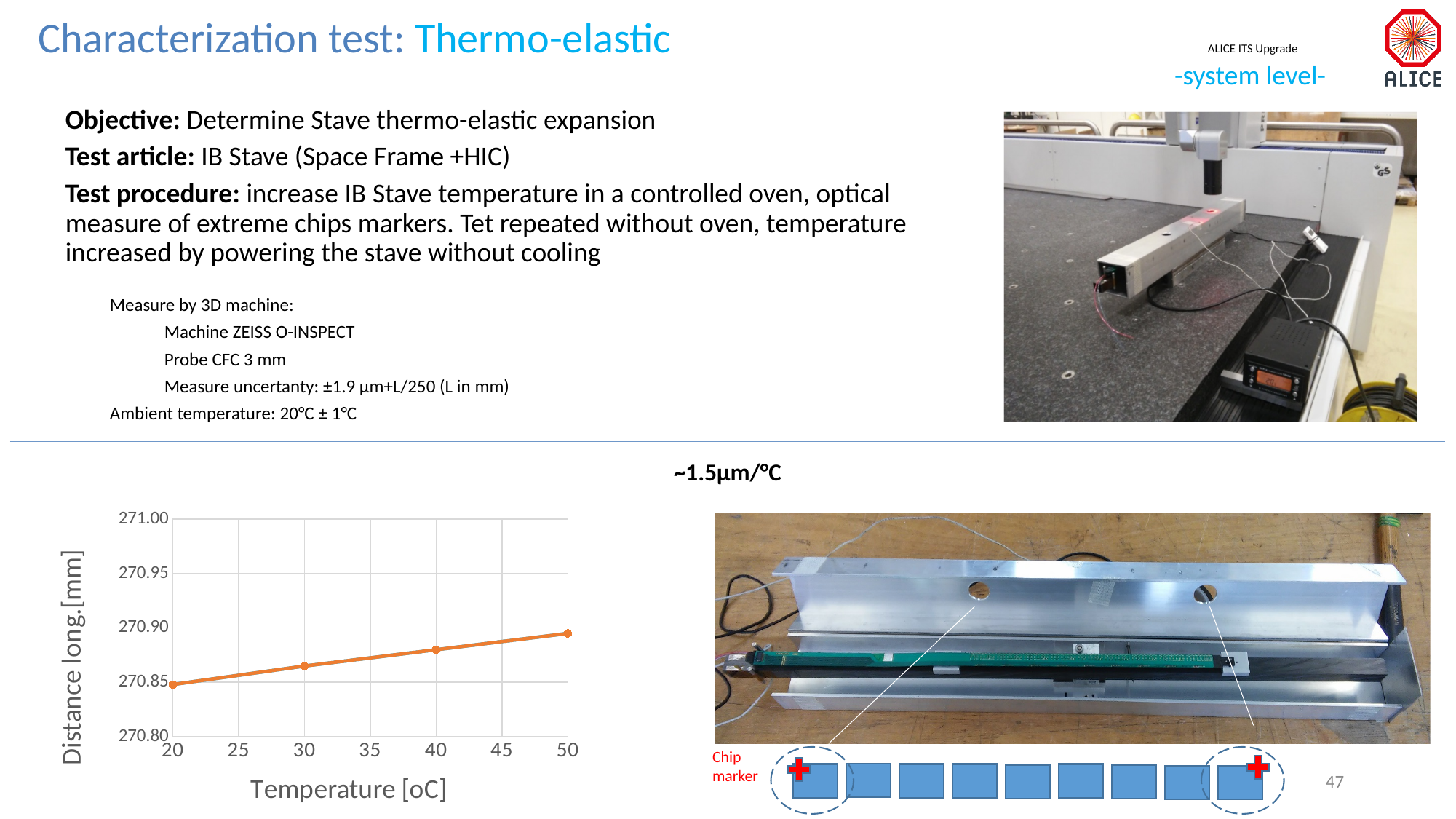
In the bottom-left chart, is the distance value at 50 degrees greater or less than 270.85? greater What is the y-axis label of the bottom-left chart? Distance long.[mm] How many data points are plotted in the bottom-left chart? 4 In the bottom-left chart, does the distance rise or fall as temperature increases along the x axis? rise In the bottom-left chart, which has the larger distance value: 20 or 50 degrees? 50 What is the x-axis label of the bottom-left chart? Temperature [oC] In the bottom-left chart, at which temperature is the measured distance lowest? 20 In the bottom-left chart, is the distance value at 30 degrees greater or less than 270.85? greater In the bottom-left chart, is the distance value at 30 degrees greater or less than 270.90? less In the bottom-left chart, at which temperature is the measured distance highest? 50 What kind of chart is shown at the bottom left of the slide? line chart